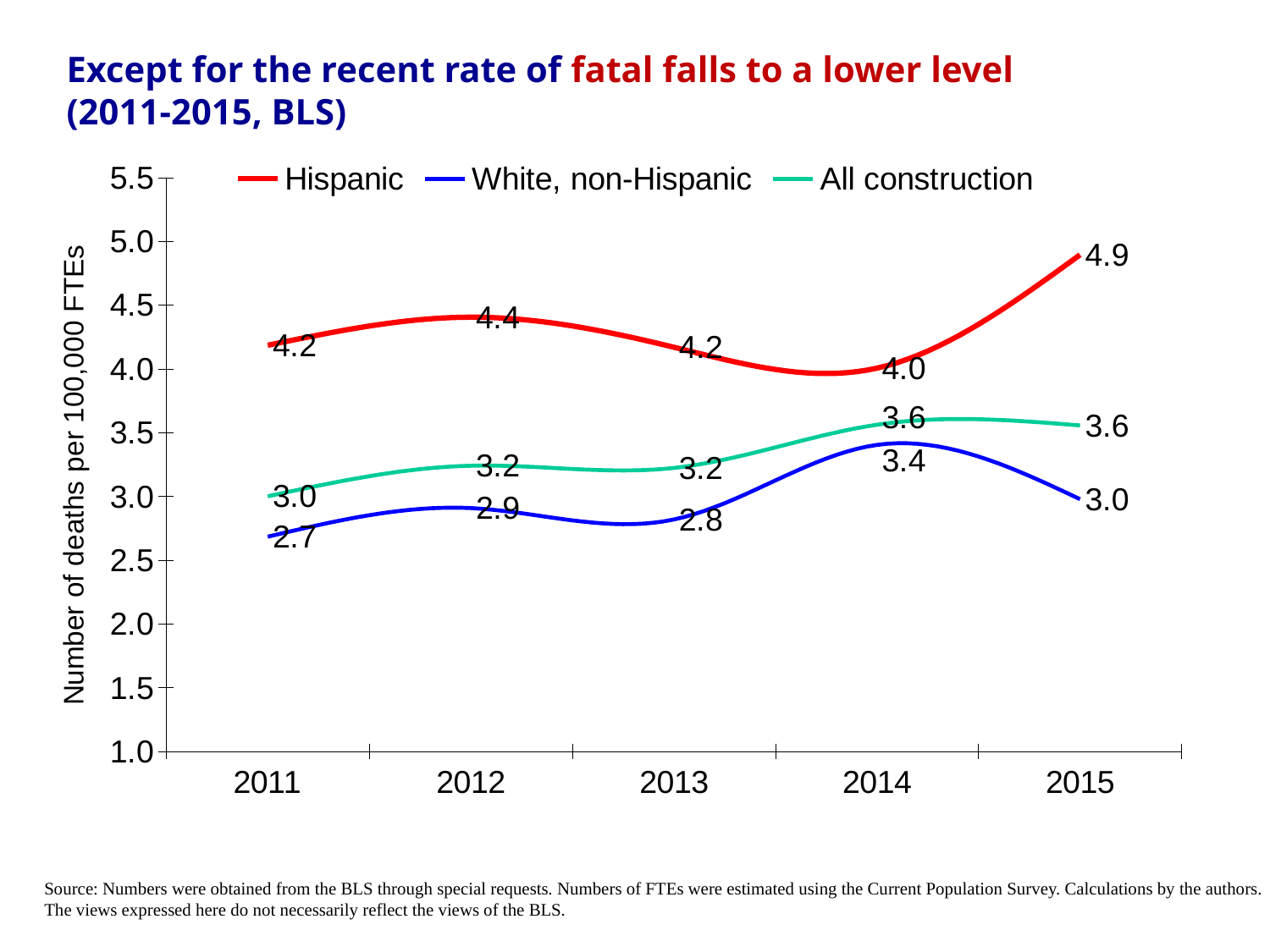
In which year is the White, non-Hispanic rate lowest? 2011 In which year is the Hispanic rate highest? 2015 How many years are shown on the x axis? 5 How many series does the legend list? 3 What kind of chart is shown on the slide? Line chart What is the label of the y axis? Number of deaths per 100,000 FTEs What is the Hispanic rate of fatal falls to a lower level in 2015? 4.9 What is the White, non-Hispanic rate in 2011? 2.7 What is the difference between the Hispanic rate and the White, non-Hispanic rate in 2015? 1.9 Which series has the higher rate in 2013, Hispanic or All construction? Hispanic What is the All construction rate in 2014? 3.6 Is the Hispanic rate in 2014 greater or less than 3.5? greater